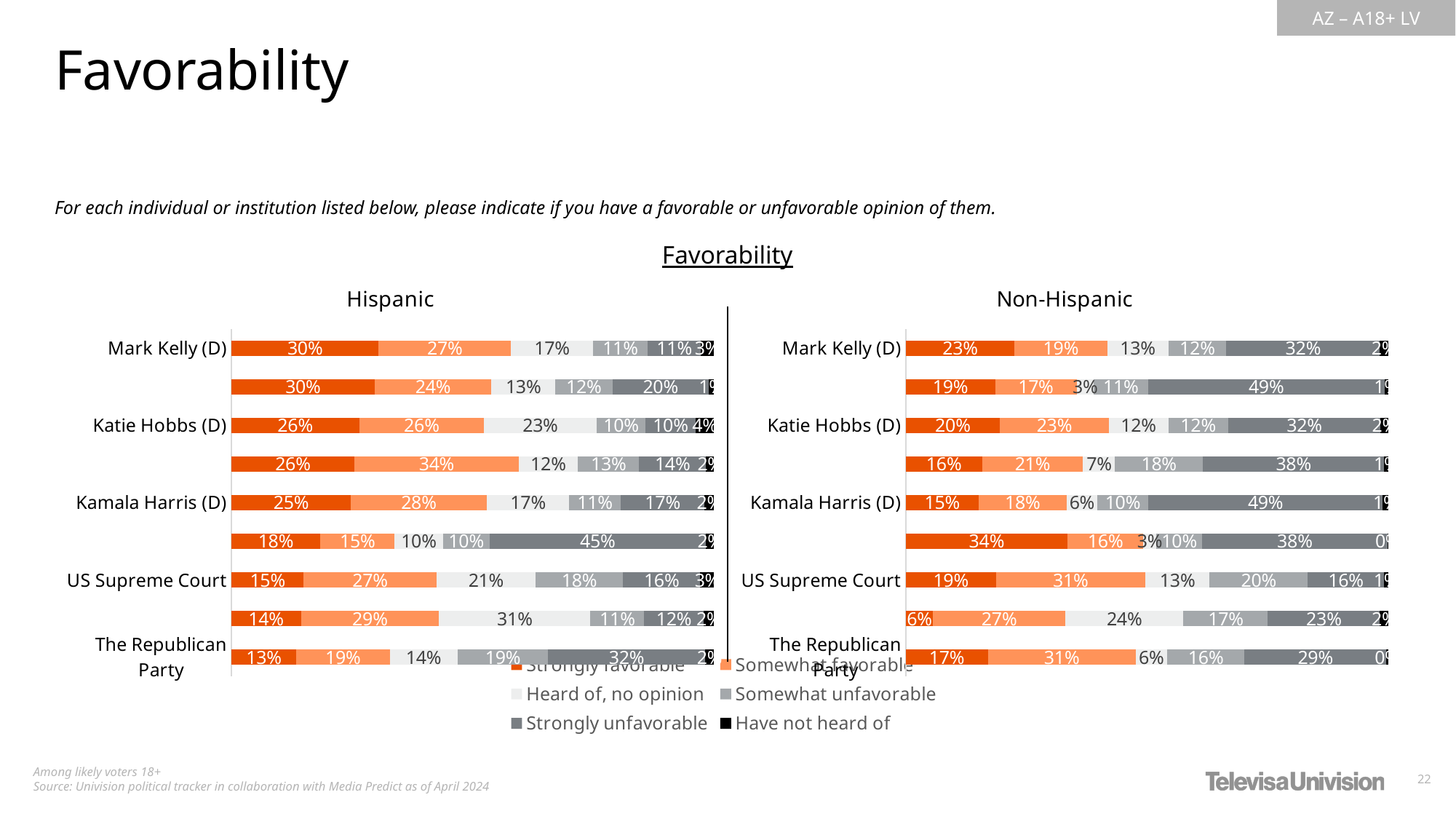
What kind of chart is used to show favorability on this slide? Stacked bar chart In the Hispanic chart, what percentage of respondents are strongly unfavorable toward The Republican Party? 32% In the Non-Hispanic chart, what percentage of respondents are somewhat favorable toward the US Supreme Court? 31% Which legend entry is shown in black? Have not heard of In the Hispanic chart, what percentage of respondents are strongly favorable toward Mark Kelly (D)? 30% In the Hispanic chart, is the somewhat favorable share for the US Supreme Court larger or smaller than the somewhat favorable share for The Republican Party? Larger Is the strongly unfavorable share for Katie Hobbs (D) larger in the Hispanic chart or the Non-Hispanic chart? Non-Hispanic In the Non-Hispanic chart, which segment is the largest in the Kamala Harris (D) bar? Strongly unfavorable What is the difference between the strongly favorable share for Mark Kelly (D) in the Hispanic chart and in the Non-Hispanic chart? 7 percentage points How many series does the legend list? 6 In the Hispanic chart, what percentage of respondents have heard of Katie Hobbs (D) but have no opinion? 23% In the Non-Hispanic chart, what percentage of respondents are strongly unfavorable toward Kamala Harris (D)? 49%